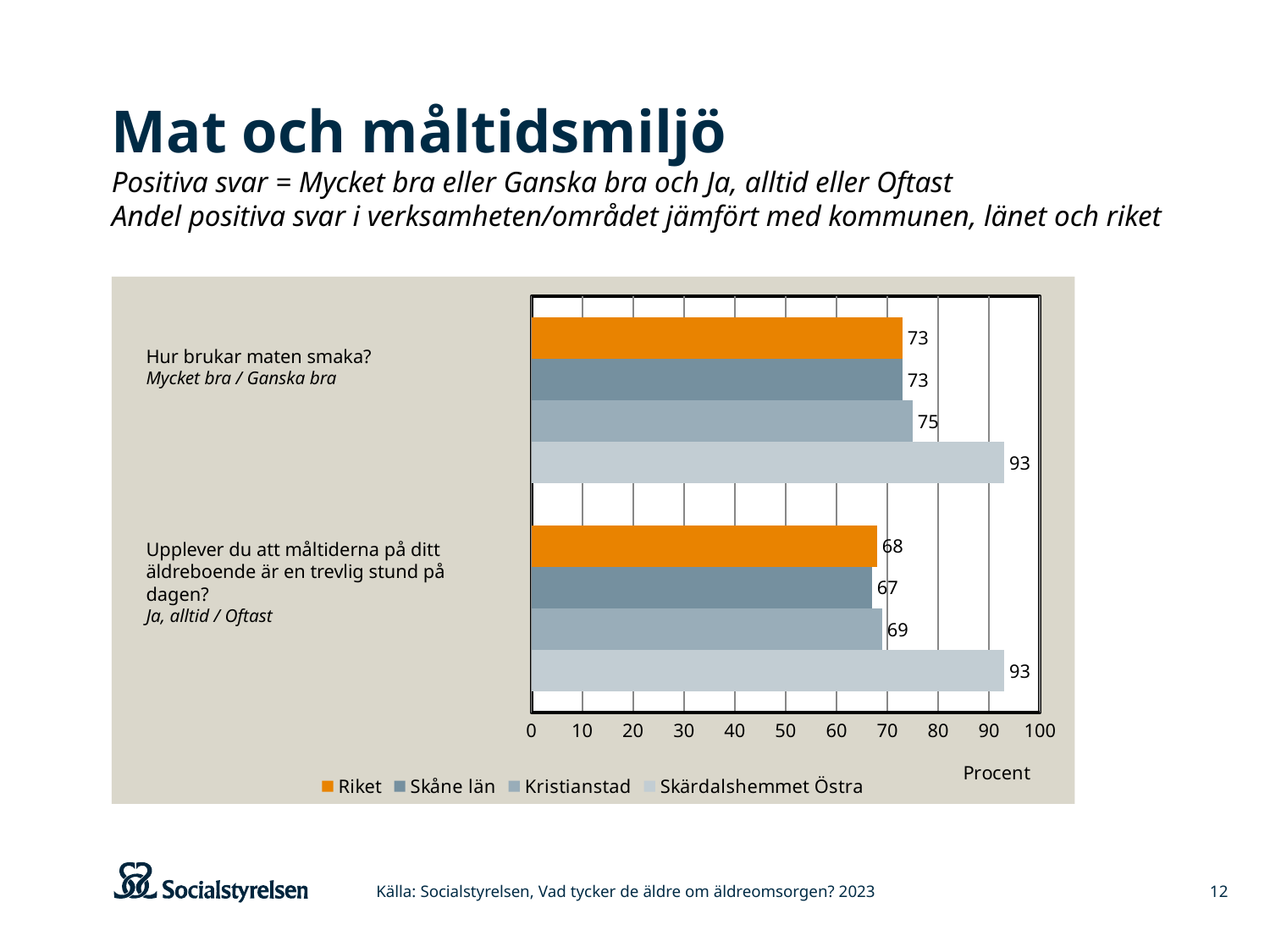
What is the difference between Riket and Skåne län for "Upplever du att måltiderna på ditt äldreboende är en trevlig stund på dagen?"? 1 What is the value for Skärdalshemmet Östra for "Hur brukar maten smaka?"? 93 Which series has the highest value for "Hur brukar maten smaka?"? Skärdalshemmet Östra Which is larger for "Hur brukar maten smaka?": Kristianstad or Riket? Kristianstad What kind of chart is shown on the slide? bar chart How many series does the legend list? 4 What is the value for Riket for "Hur brukar maten smaka?"? 73 What is the value for Skåne län for "Upplever du att måltiderna på ditt äldreboende är en trevlig stund på dagen?"? 67 Which series is shown in orange in the legend? Riket Which series has the lowest value for "Upplever du att måltiderna på ditt äldreboende är en trevlig stund på dagen?"? Skåne län What is the value for Kristianstad for "Upplever du att måltiderna på ditt äldreboende är en trevlig stund på dagen?"? 69 What is the difference between Skärdalshemmet Östra and Kristianstad for "Hur brukar maten smaka?"? 18